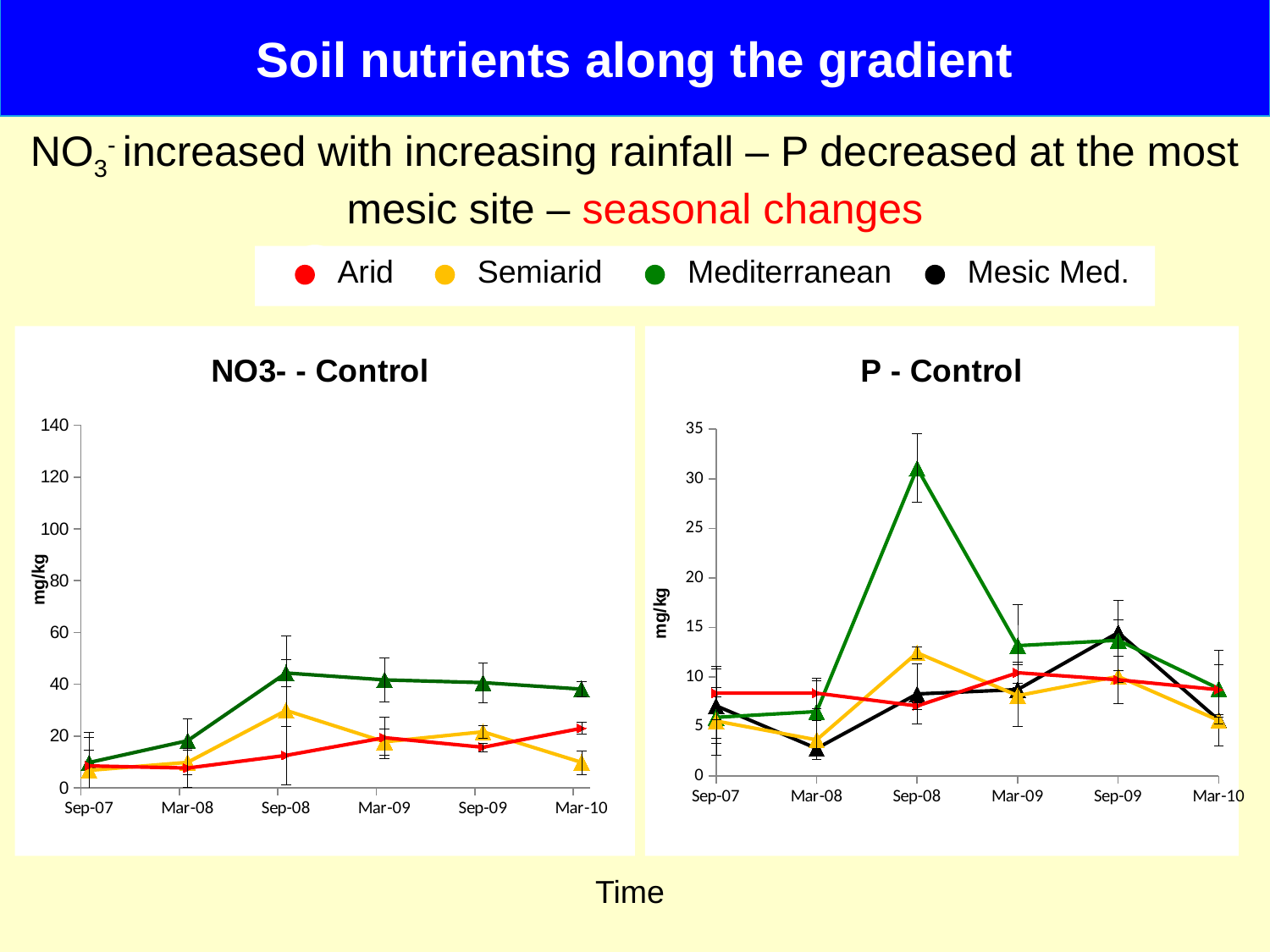
In the "NO3- - Control" chart, does the Mediterranean series rise or fall from Sep-08 to Mar-10? fall In the "NO3- - Control" chart, is the Arid value at Sep-07 greater or less than 20? less In the "P - Control" chart, which series has the highest value at Sep-08? Mediterranean How many time points are shown on the x axis of the "P - Control" chart? 6 In the "NO3- - Control" chart, which series has the lowest value at Mar-10? Semiarid In the "P - Control" chart, is the Mediterranean value at Sep-08 greater or less than 25? greater In the "NO3- - Control" chart, which series has the highest value at Sep-08? Mediterranean How many series does the legend at the top of the slide list? 4 In the "NO3- - Control" chart, is the Mediterranean value at Sep-08 greater or less than 20? greater What kind of chart is the "NO3- - Control" chart? line chart What is the y-axis label on the "P - Control" chart? mg/kg In the "P - Control" chart, is the Mediterranean value larger at Sep-08 or at Mar-09? Sep-08